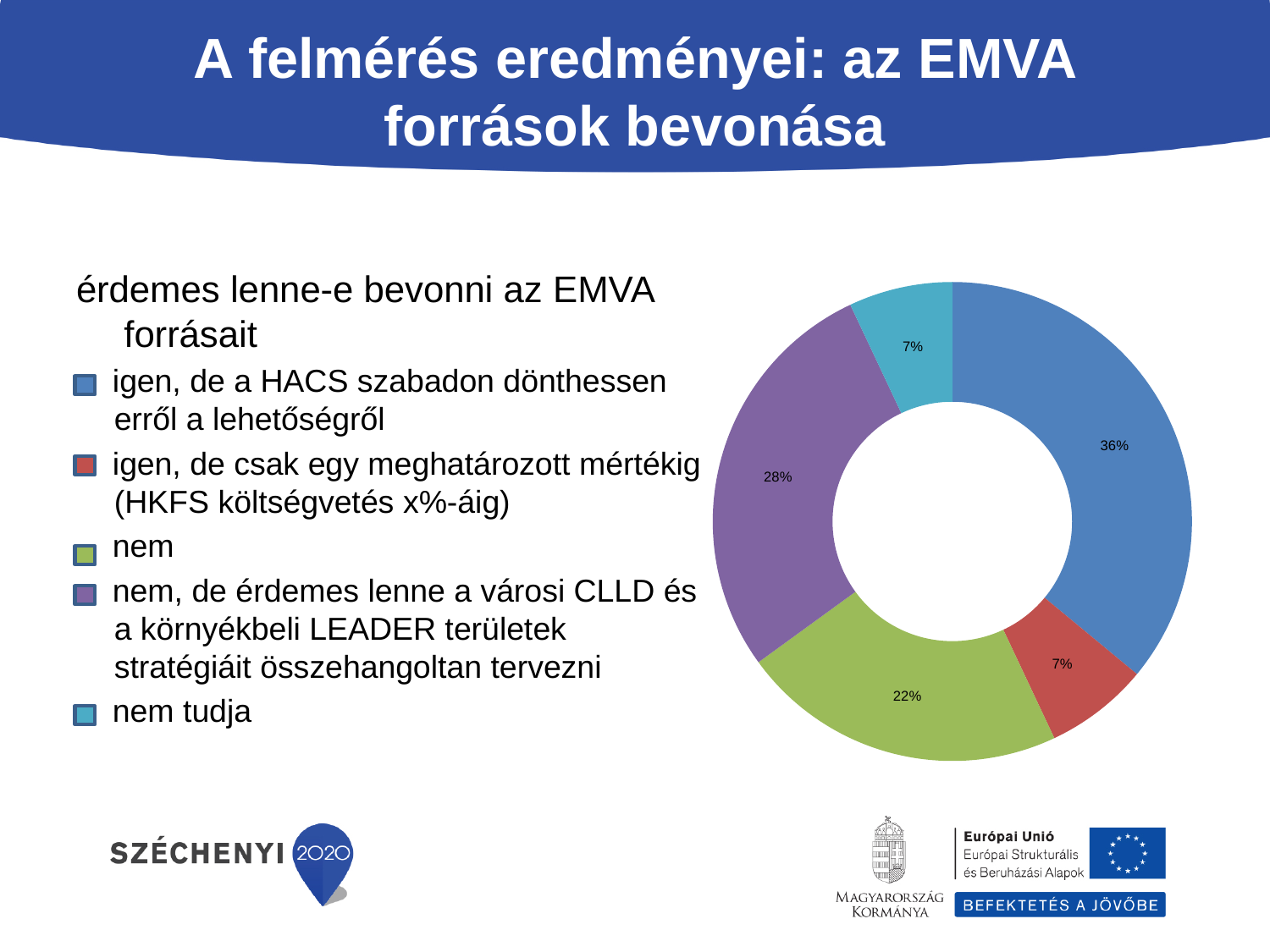
How many answer categories are shown in the chart? 5 What question does the chart summarise, according to the legend heading? érdemes lenne-e bevonni az EMVA forrásait What share is shown for "nem, de érdemes lenne a városi CLLD és a környékbeli LEADER területek stratégiáit összehangoltan tervezni"? 28% What is the difference in percentage points between the "igen, de a HACS szabadon dönthessen" slice and the "nem" slice? 14 percentage points What is the combined share of the two "igen" (yes) answer options? 43% Which answer option has the largest share in the chart? igen, de a HACS szabadon dönthessen erről a lehetőségről Which colour represents the "nem" category in the chart? Green Which is larger: the share for "nem" or the share for "nem, de érdemes lenne a városi CLLD és a környékbeli LEADER területek stratégiáit összehangoltan tervezni"? nem, de érdemes lenne a városi CLLD és a környékbeli LEADER területek stratégiáit összehangoltan tervezni What percentage of respondents chose "nem tudja"? 7% What percentage is shown for "igen, de a HACS szabadon dönthessen erről a lehetőségről"? 36% What share of respondents answered "nem" (no) in the chart? 22% What type of chart is shown on the slide? Doughnut (pie) chart